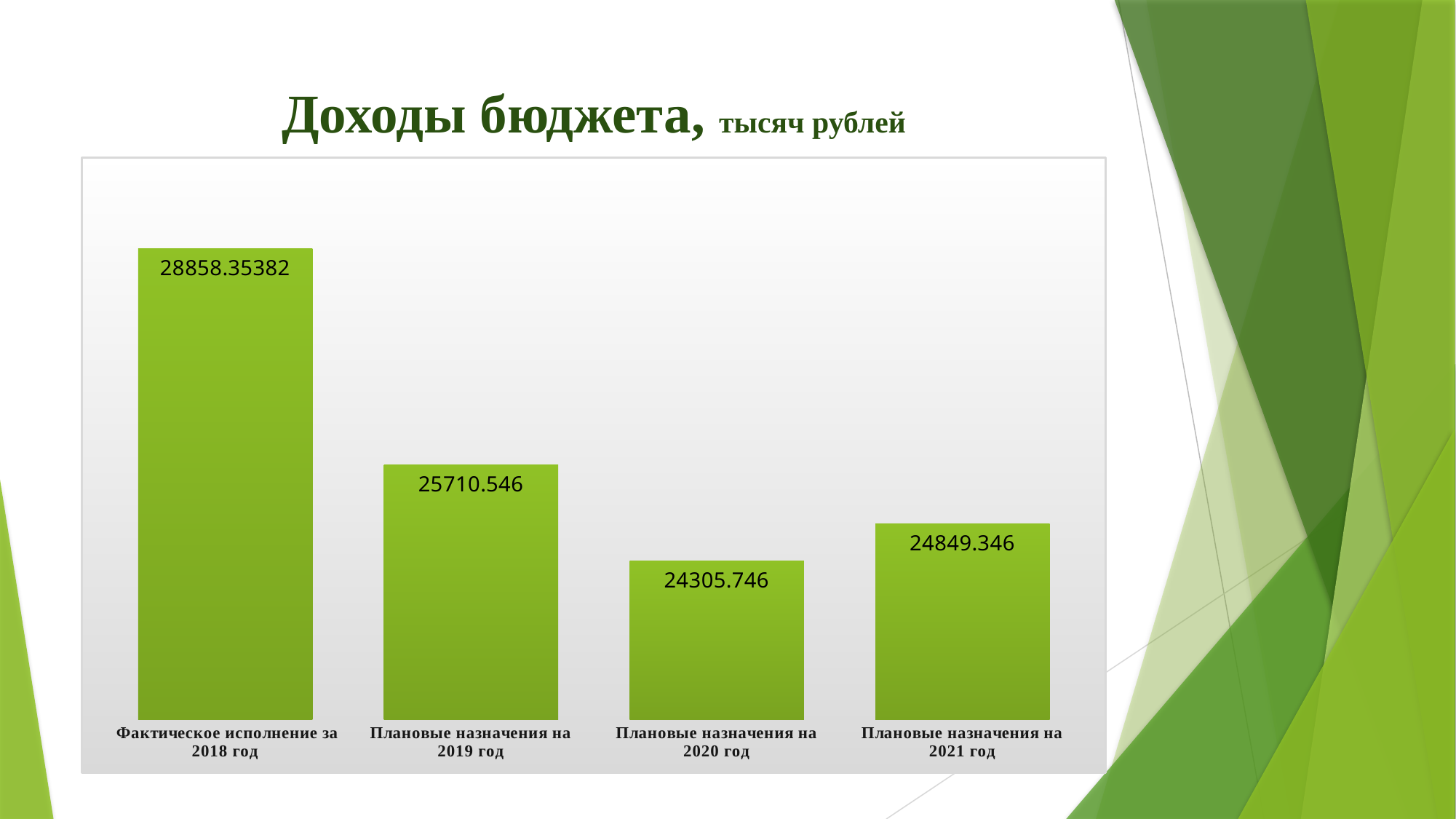
Which category has the lowest value? Плановые назначения на 2020 год What kind of chart is shown on the slide? Bar chart Which is larger: the value for Плановые назначения на 2020 год or Плановые назначения на 2021 год? Плановые назначения на 2021 год What is the difference between the values for Плановые назначения на 2021 год and Плановые назначения на 2020 год? 543.600 What is the value for Плановые назначения на 2020 год? 24305.746 Which category has the highest value? Фактическое исполнение за 2018 год What is the difference between the values for Плановые назначения на 2019 год and Плановые назначения на 2020 год? 1404.800 What is the value for Фактическое исполнение за 2018 год? 28858.35382 What is the title of the chart? Доходы бюджета, тысяч рублей How many bars are shown in the chart? 4 What is the value for Плановые назначения на 2021 год? 24849.346 What is the value for Плановые назначения на 2019 год? 25710.546